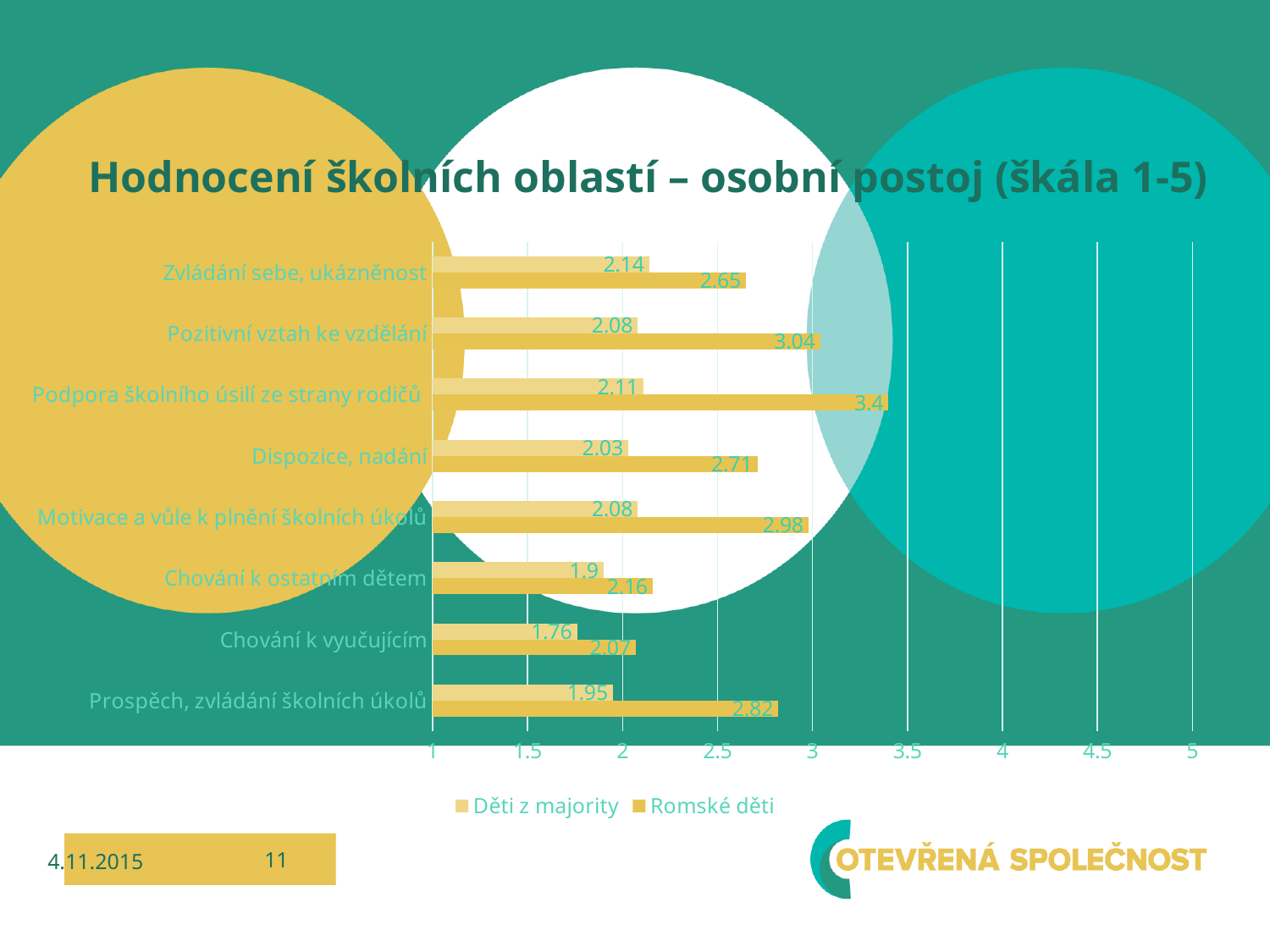
Which category has the highest value for Romské děti? Podpora školního úsilí ze strany rodičů Which is larger in the category Pozitivní vztah ke vzdělání: the value for Děti z majority or for Romské děti? Romské děti What is the difference between the Romské děti and Děti z majority values in the category Podpora školního úsilí ze strany rodičů? 1.29 How many series does the legend list? 2 How many categories are shown on the chart? 8 Is the value for Romské děti in the category Motivace a vůle k plnění školních úkolů greater or less than 2.5? greater What is the title of the chart? Hodnocení školních oblastí – osobní postoj (škála 1-5) What is the value for Romské děti in the category Podpora školního úsilí ze strany rodičů? 3.4 Which category has the lowest value for Děti z majority? Chování k vyučujícím What is the value for Romské děti in the category Prospěch, zvládání školních úkolů? 2.82 What kind of chart is shown on the slide? bar chart What is the value for Děti z majority in the category Chování k vyučujícím? 1.76